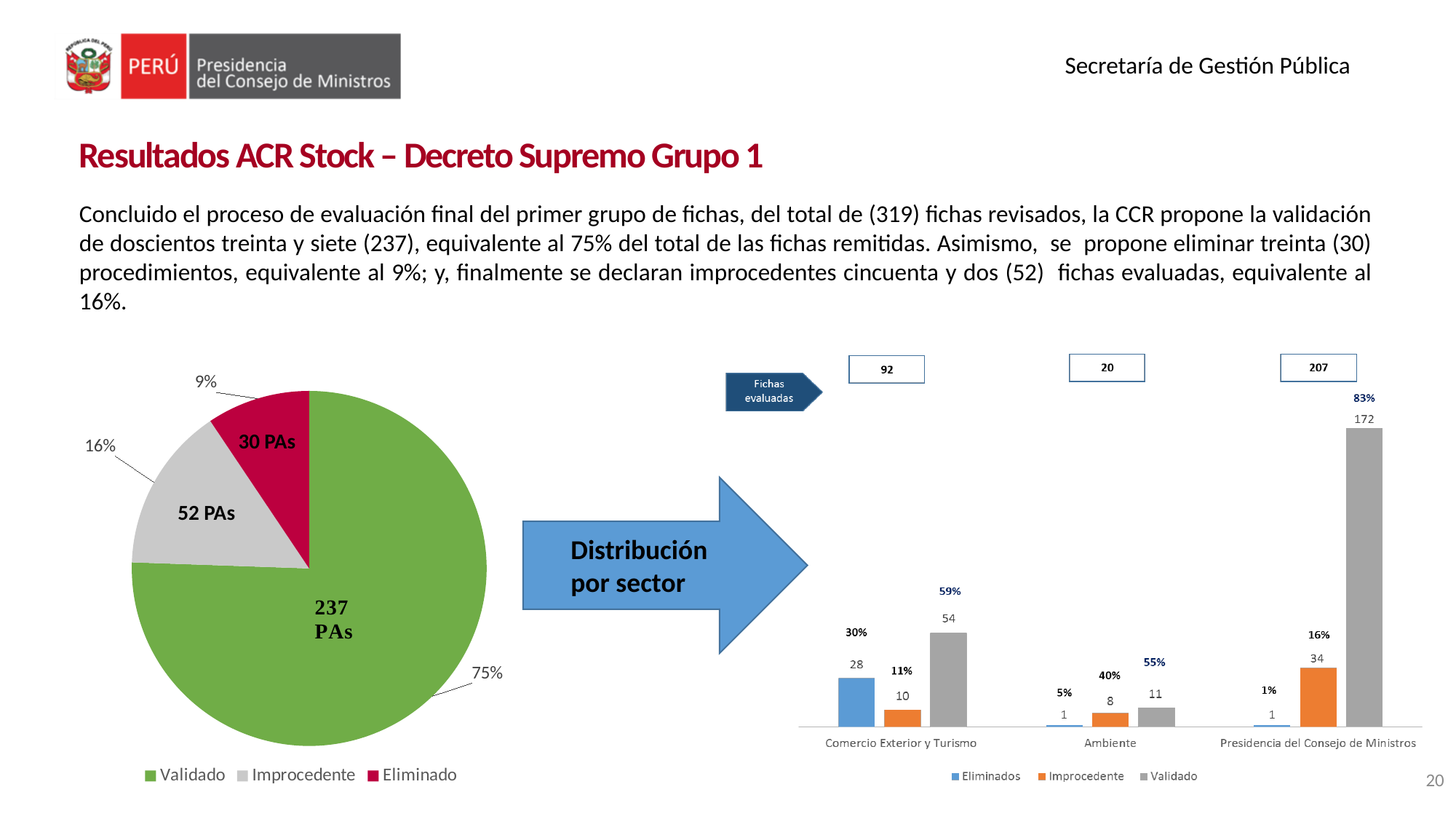
In the bar chart on the right, what is the Improcedente value for Ambiente? 8 In the bar chart on the right, what percentage label is shown above the Validado bar for Presidencia del Consejo de Ministros? 83% In the pie chart on the left, how many PAs are shown for the Improcedente slice? 52 PAs In the bar chart on the right, how many sectors are shown on the x axis? 3 In the bar chart on the right, what is the difference between the Validado values for Comercio Exterior y Turismo and Ambiente? 43 In the pie chart on the left, what share of the pie does the Validado slice represent? 75% In the bar chart on the right, which is larger: the Improcedente value for Presidencia del Consejo de Ministros or the Validado value for Comercio Exterior y Turismo? Validado value for Comercio Exterior y Turismo In the pie chart on the left, how many categories does the legend list? 3 What kind of chart is the chart on the left of the slide? Pie chart In the pie chart on the left, which category has the smallest slice? Eliminado In the bar chart on the right, which sector has the highest Eliminados value? Comercio Exterior y Turismo In the bar chart on the right, what is the Validado value for Presidencia del Consejo de Ministros? 172